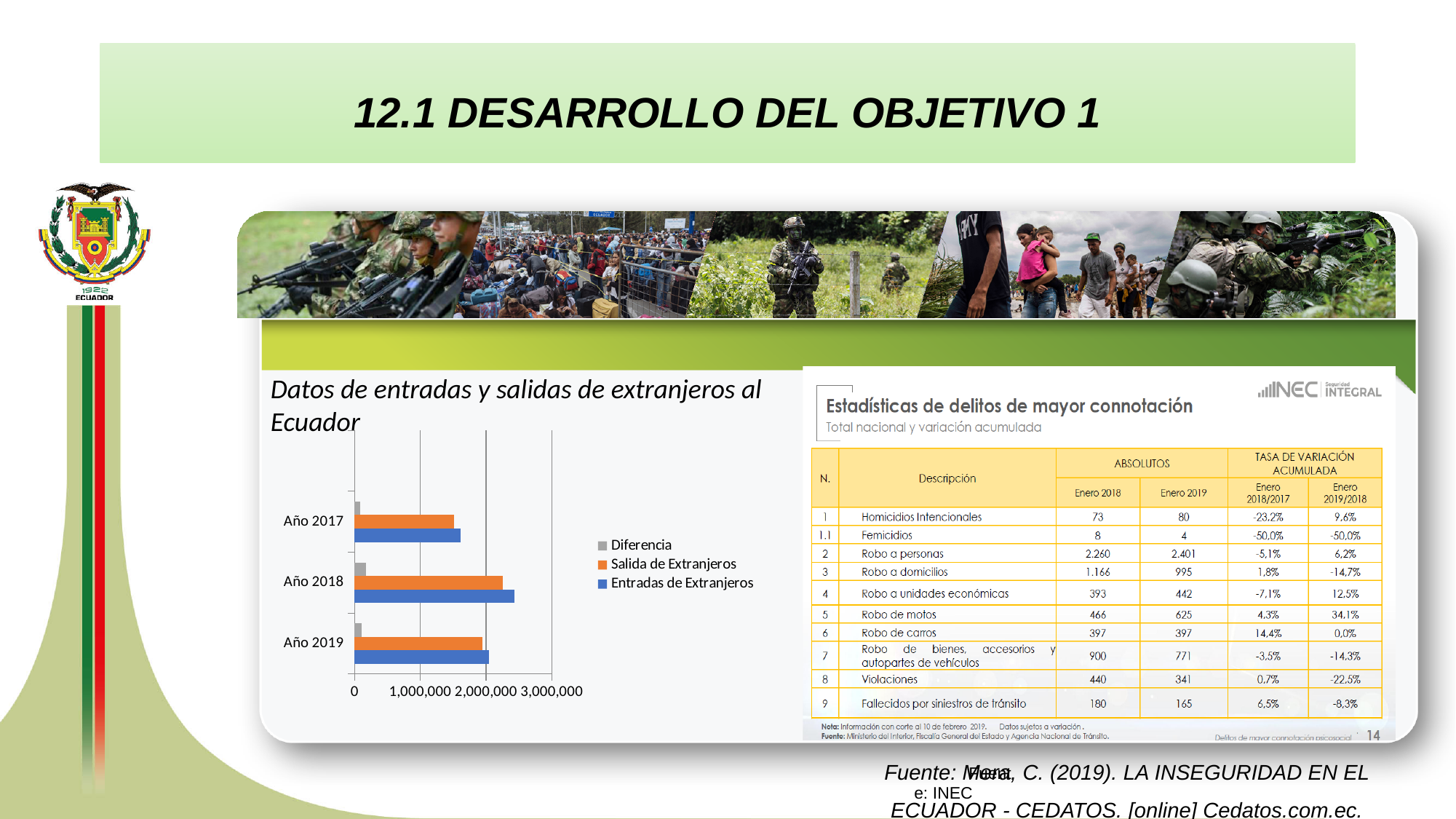
Which series are listed in the legend of the bar chart? Diferencia, Salida de Extranjeros, Entradas de Extranjeros What kind of chart is used to show the data on entries and exits of foreigners to Ecuador? Bar chart Is the value for Diferencia in Año 2018 greater or less than 1,000,000? less How many year categories are shown on the bar chart? 3 In which year is the value for Entradas de Extranjeros highest? Año 2018 How many series does the legend of the bar chart list? 3 Is the value for Entradas de Extranjeros in Año 2018 greater or less than 2,000,000? greater In Año 2018, which is larger: Entradas de Extranjeros or Salida de Extranjeros? Entradas de Extranjeros In which year is the value for Salida de Extranjeros highest? Año 2018 What is the title of the bar chart? Datos de entradas y salidas de extranjeros al Ecuador Is the value for Entradas de Extranjeros in Año 2017 greater or less than 2,000,000? less Which is larger: Entradas de Extranjeros in Año 2018 or Entradas de Extranjeros in Año 2017? Año 2018